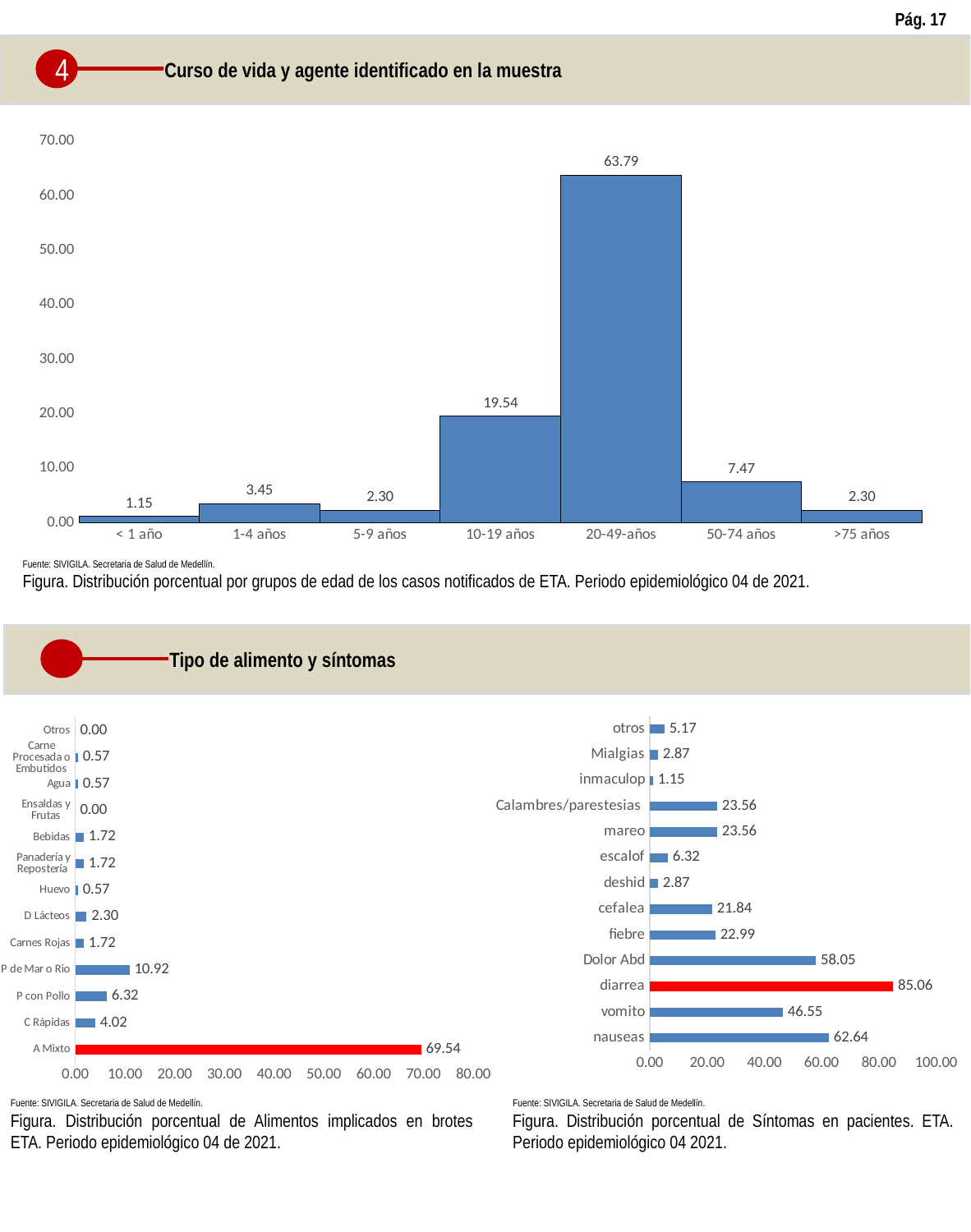
In the bottom-left chart (foods), what colour is the bar for A Mixto? Red In the top chart (age groups), which age group has the lowest value? < 1 año In the top chart (age groups), how many age groups are shown? 7 In the bottom-left chart (foods), what is the value for A Mixto? 69.54 In the bottom-right chart (symptoms), what is the difference between the values for nauseas and Dolor Abd? 4.59 In the bottom-left chart (foods), how many food categories are listed? 13 In the bottom-left chart (foods), which is larger, P de Mar o Rio or P con Pollo? P de Mar o Rio In the top chart (age groups), what is the difference between the values for 10-19 años and 50-74 años? 12.07 In the top chart (age groups), what is the value for 20-49-años? 63.79 In the bottom-right chart (symptoms), which symptom has the highest value? diarrea In the bottom-right chart (symptoms), what is the value for vomito? 46.55 In the top chart (age groups), what type of chart is used? Bar chart